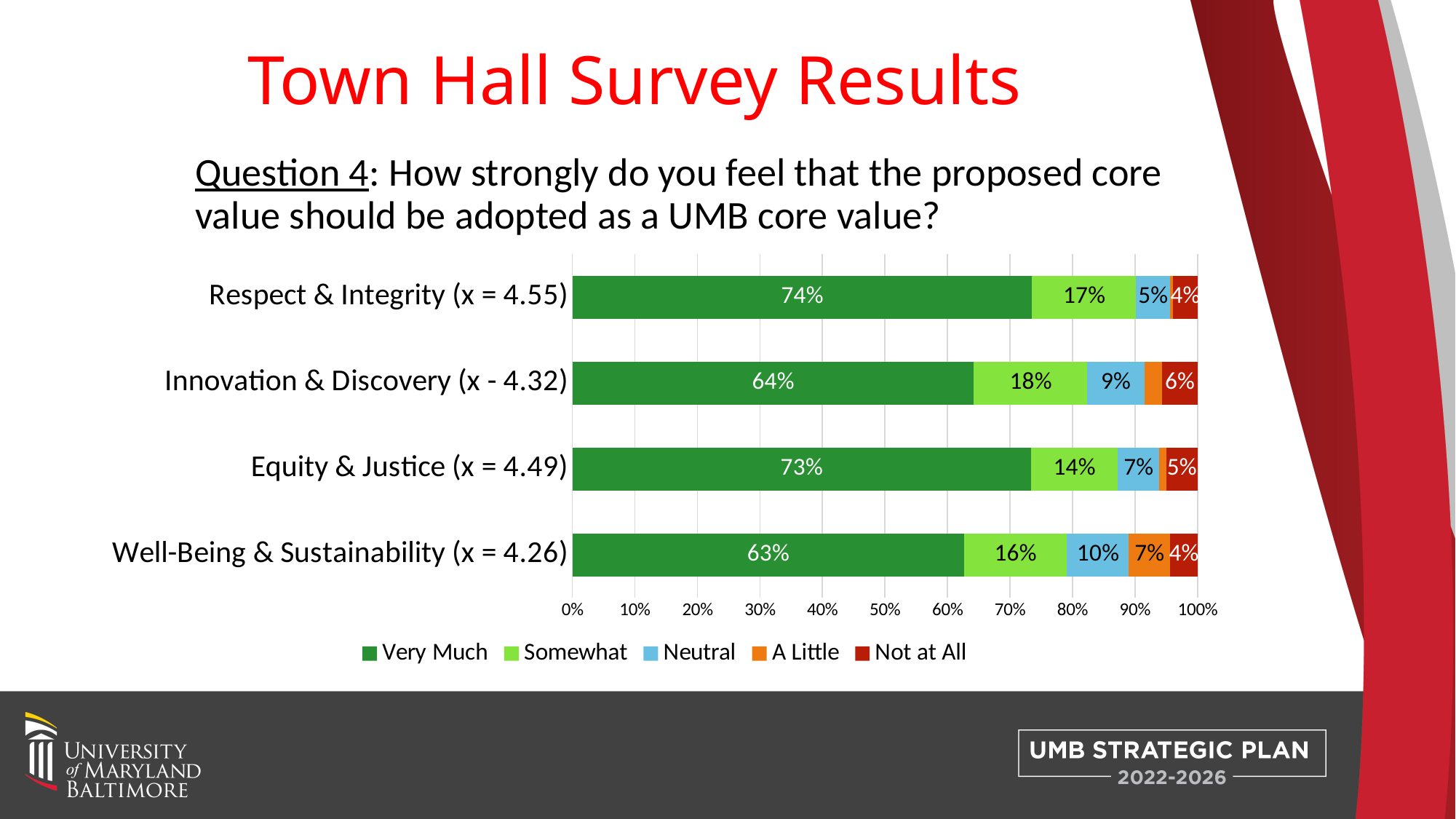
What is the "Neutral" value for Well-Being & Sustainability? 10% Which legend entry is shown in dark red? Not at All How many series does the legend list? 5 What percentage of respondents answered "Very Much" for Respect & Integrity? 74% What is the "Not at All" value for Equity & Justice? 5% Which core value has the lowest "Very Much" percentage? Well-Being & Sustainability What is the difference between the "Very Much" percentages for Respect & Integrity and Well-Being & Sustainability? 11% Which is larger: the "Neutral" value for Innovation & Discovery or for Equity & Justice? Innovation & Discovery What is the "Somewhat" value for Innovation & Discovery? 18% What kind of chart is shown on the slide? Stacked bar chart Which core value has the highest "Very Much" percentage? Respect & Integrity How many core values (categories) are shown in the chart? 4